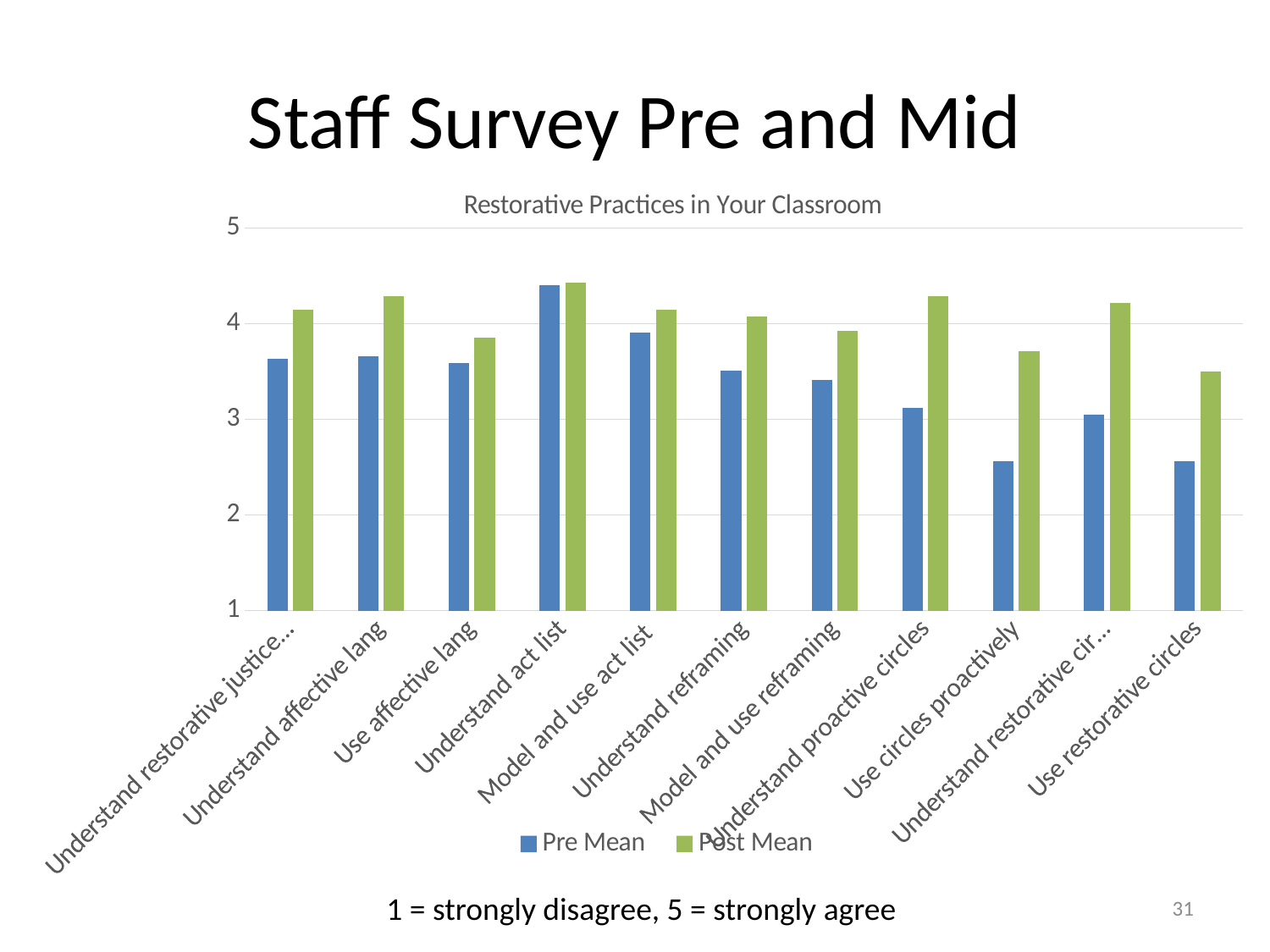
What kind of chart is shown on the slide? bar chart Which category has the highest Pre Mean value? Understand act list What is the title of the chart? Restorative Practices in Your Classroom How many series does the legend list? 2 Is the Post Mean value for Understand proactive circles greater or less than 4? greater Which has the larger Pre Mean value: Model and use act list or Understand reframing? Model and use act list Is the Pre Mean value for Understand act list greater or less than 4? greater How many categories are shown on the x axis? 11 For Understand proactive circles, which is larger: the Pre Mean or the Post Mean? Post Mean Which category has the lowest Post Mean value? Use restorative circles Is the Pre Mean value for Use circles proactively greater or less than 3? less